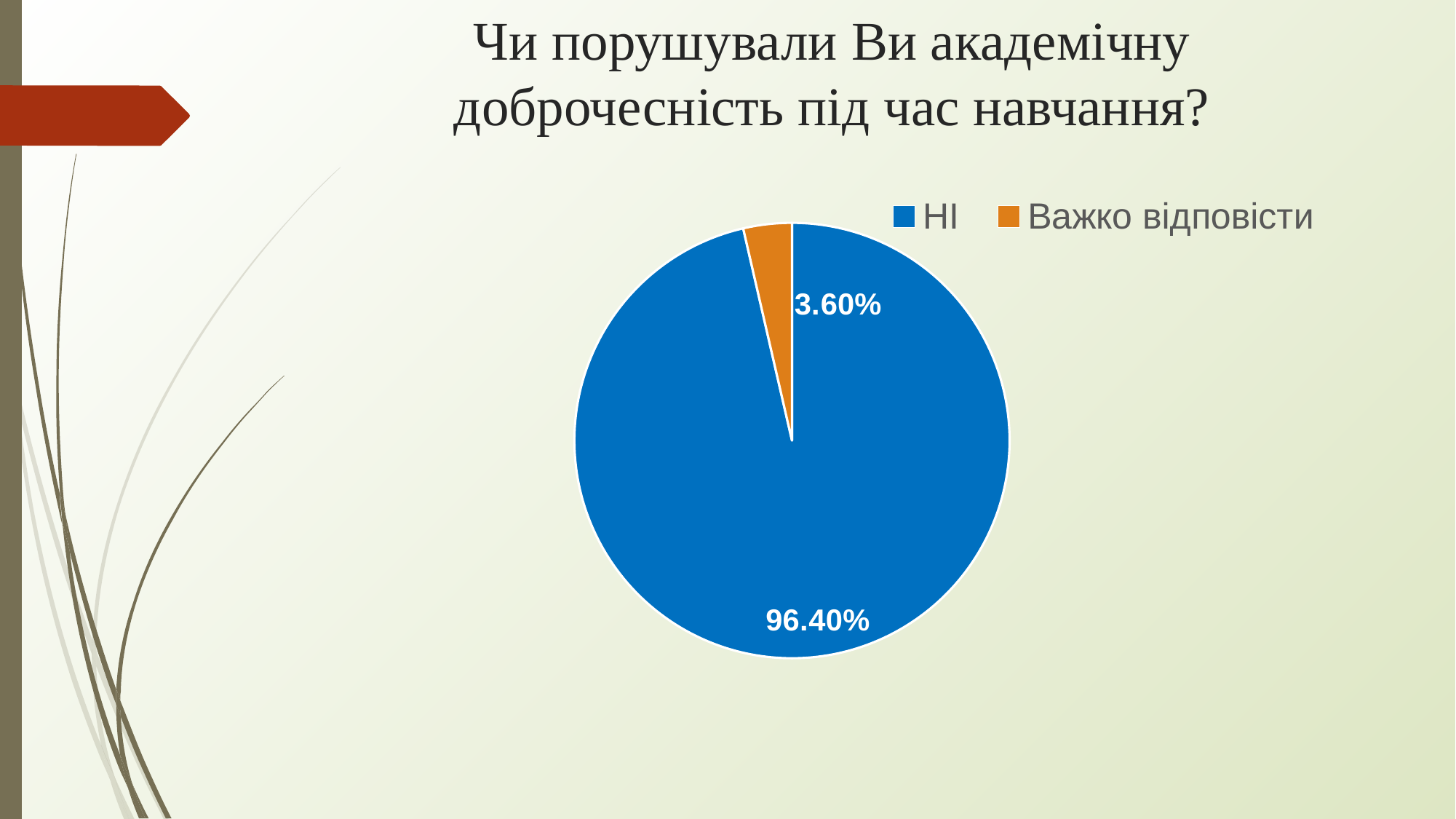
What colour is the "НІ" slice? blue Which category has the largest slice of the pie? НІ Which is larger: the share for "НІ" or the share for "Важко відповісти"? НІ How many slices does the pie chart have? 2 Which category has the smallest slice of the pie? Важко відповісти What share of the pie does the "Важко відповісти" slice represent? 3.60% What share of the pie does the "НІ" slice represent? 96.40% What is the difference between the "НІ" share and the "Важко відповісти" share? 92.80% How many entries does the legend list? 2 What colour is the "Важко відповісти" slice? orange What kind of chart is shown on the slide? pie chart